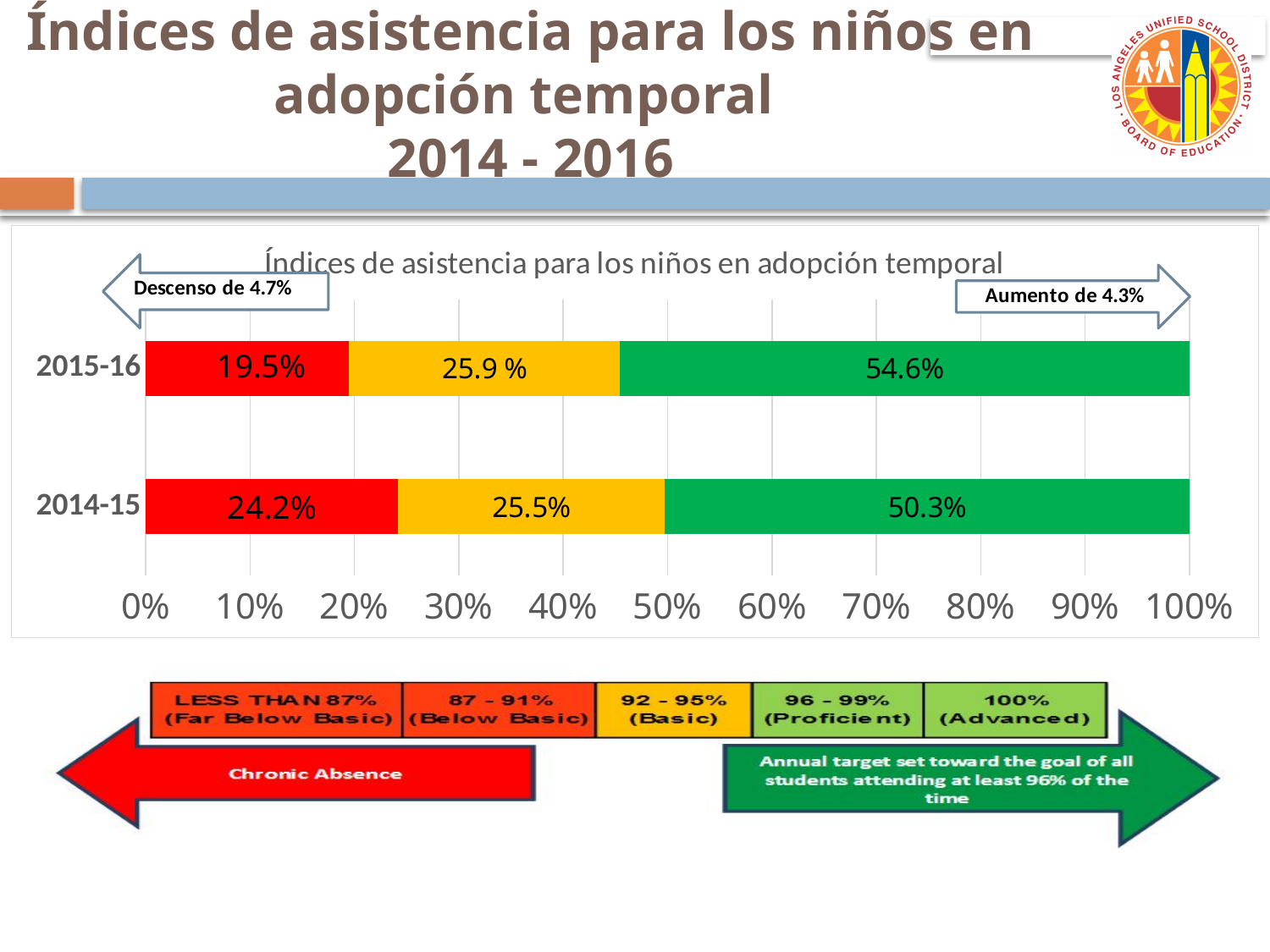
What is the value of the green segment for 2014-15? 50.3% Which year has the larger red segment, 2015-16 or 2014-15? 2014-15 Is the green segment value for 2015-16 greater or less than 50%? greater What is the difference between the red segment values for 2014-15 and 2015-16? 4.7% How many year categories are shown in the chart? 2 What is the title of the chart? Índices de asistencia para los niños en adopción temporal What is the value of the yellow segment for 2015-16? 25.9 % What kind of chart is shown on the slide? Stacked bar chart Which year has the larger green segment, 2015-16 or 2014-15? 2015-16 What is the value of the red segment for 2014-15? 24.2% What is the difference between the green segment values for 2015-16 and 2014-15? 4.3% What is the value of the red segment for 2015-16? 19.5%